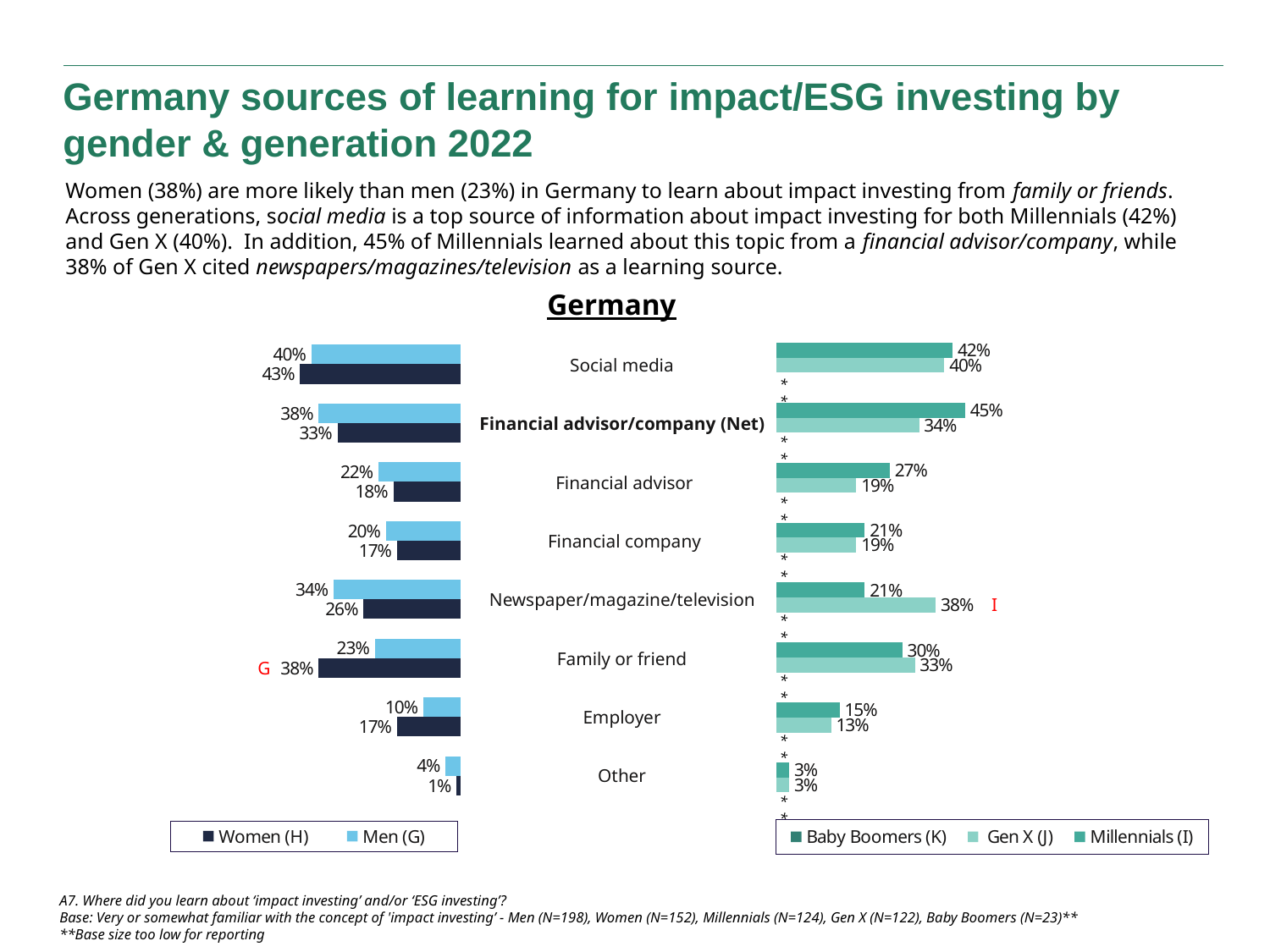
On the gender chart (left), which source has the lowest value for men? Other On the generation chart (right), what is the difference between Millennials and Gen X for financial advisor/company (Net)? 11 percentage points How many learning-source categories are shown on the gender chart (left)? 8 What type of chart is used on the left side of the slide? Bar chart On the gender chart (left), what percentage of women in Germany learned about impact investing from family or friends? 38% How many series does the legend of the generation chart (right) list? 3 On the gender chart (left), what is the difference between men and women for newspaper/magazine/television? 8 percentage points On the generation chart (right), which is larger for family or friend: Millennials or Gen X? Gen X On the generation chart (right), what percentage of Millennials learned about impact investing from a financial advisor/company (Net)? 45% On the generation chart (right), what percentage of Gen X cited newspaper/magazine/television? 38% On the gender chart (left), what percentage of men cited social media as a learning source? 40% On the gender chart (left), which source has the highest value for women? Social media